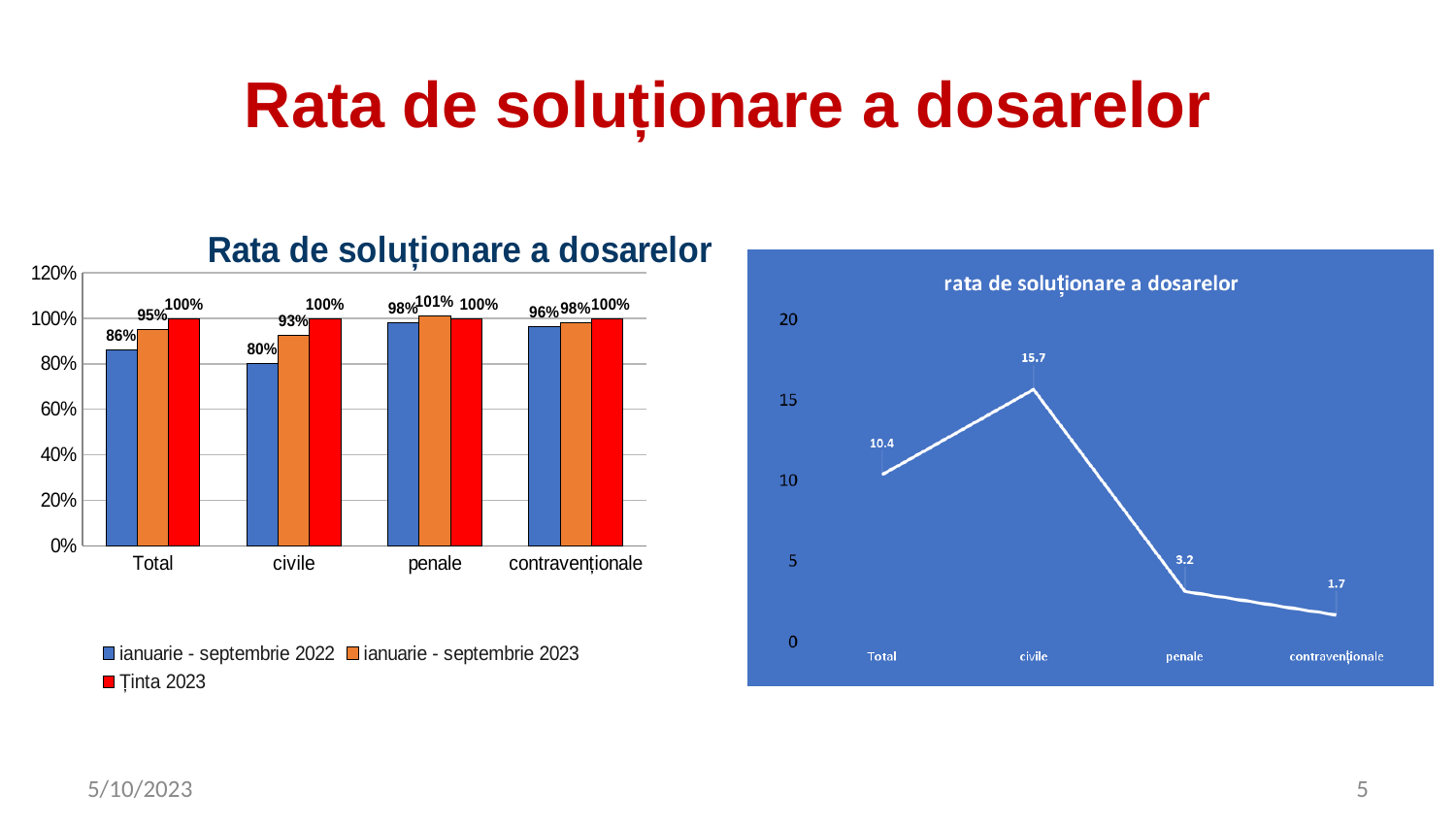
In the left bar chart, what is the Ținta 2023 value for contravenționale? 100% How many series does the legend of the left bar chart list? 3 In the right line chart, which category has the lowest value? contravenționale How many categories are shown on the x axis of the right line chart? 4 In the left bar chart, which is larger for civile: the ianuarie - septembrie 2022 value or the ianuarie - septembrie 2023 value? ianuarie - septembrie 2023 In the left bar chart, which category has the lowest value in the ianuarie - septembrie 2022 series? civile In the left bar chart, what is the value for penale in the ianuarie - septembrie 2023 series? 101% In the left bar chart, what is the value for civile in the ianuarie - septembrie 2022 series? 80% In the right line chart, what is the difference between the values for civile and penale? 12.5 In the left bar chart, what is the difference between the ianuarie - septembrie 2023 and ianuarie - septembrie 2022 values for Total? 9% What kind of chart is the chart on the right side of the slide? line chart In the right line chart, what is the value for civile? 15.7